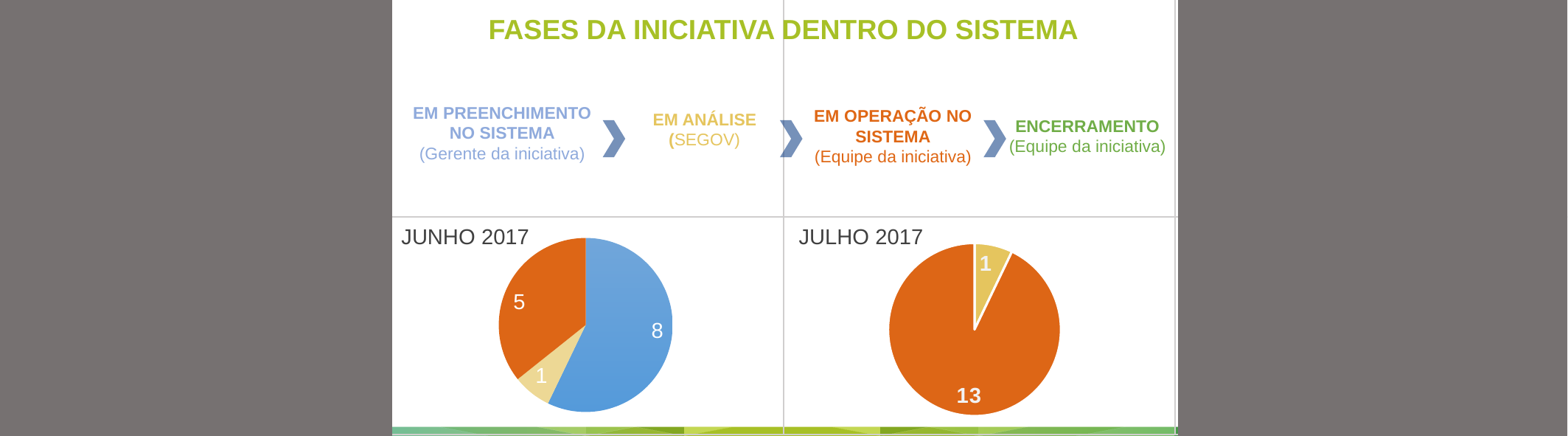
In the JUNHO 2017 pie chart, what value is shown for the orange slice? 5 How many slices does the JULHO 2017 pie chart have? 2 In the JUNHO 2017 pie chart, which slice is the largest? The blue slice (8) In the JUNHO 2017 pie chart, what value is shown for the blue slice? 8 In the JUNHO 2017 pie chart, what is the difference between the blue slice and the orange slice? 3 Which is larger: the orange slice in the JUNHO 2017 chart or the orange slice in the JULHO 2017 chart? JULHO 2017 (13) In the JULHO 2017 pie chart, what value is shown for the yellow slice? 1 In the JULHO 2017 pie chart, what value is shown for the orange slice? 13 What kind of charts are shown on the slide for JUNHO 2017 and JULHO 2017? Pie charts In the JUNHO 2017 pie chart, what is the total of all slices? 14 How many slices does the JUNHO 2017 pie chart have? 3 In the JUNHO 2017 pie chart, what is the value of the smallest slice? 1